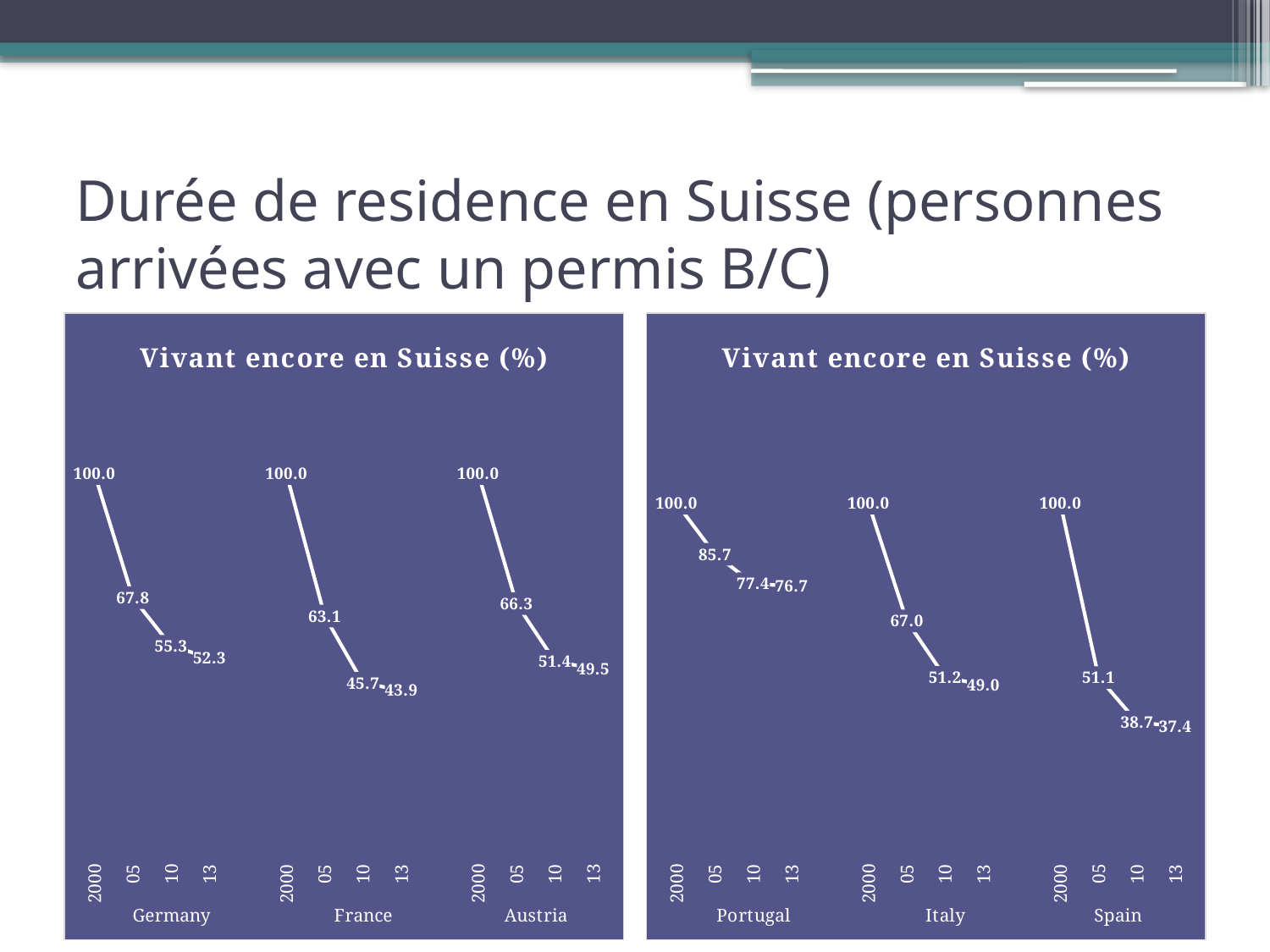
In the left chart, what is the value for Germany in 2013? 52.3 In the right chart, what is the value for Spain in 2013? 37.4 What type of chart is the left chart? line chart In the right chart, what is the value for Portugal in 2010? 77.4 In the right chart, what is the difference between Portugal's and Italy's values in 2005? 18.7 In the left chart, which country has the highest value in 2013? Germany In the left chart, what is the difference between Germany's and France's values in 2013? 8.4 How many countries are shown in the right chart? 3 In the right chart, which is larger: Italy's value in 2010 or Spain's value in 2005? Italy's value in 2010 In the right chart, which country has the lowest value in 2013? Spain In the left chart, what is the value for France in 2005? 63.1 In the left chart, do the values for Austria rise or fall from 2000 to 2013? fall